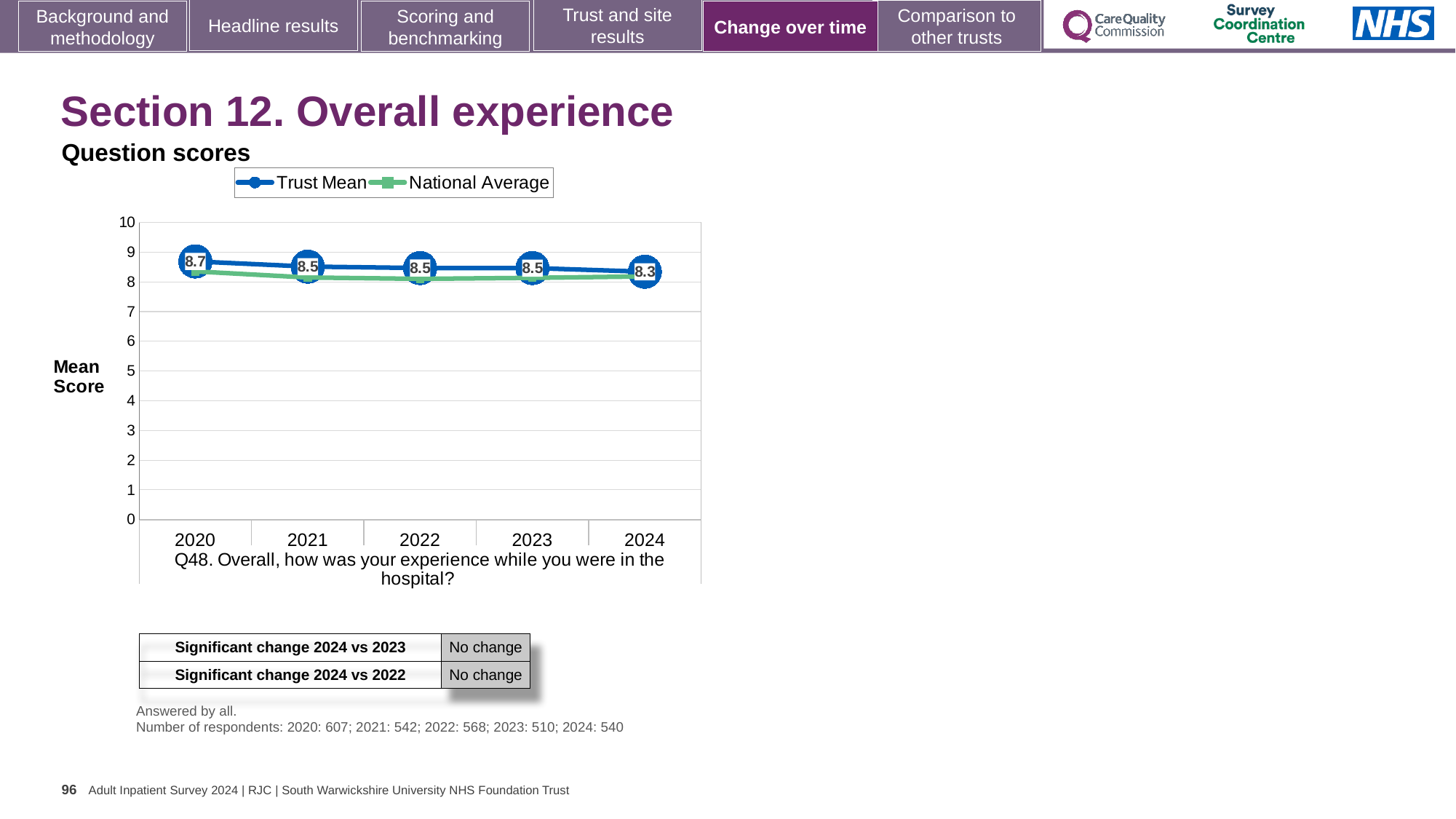
What is the difference between the Trust Mean score in 2020 and in 2024? 0.4 In which year is the Trust Mean score highest? 2020 What is the Trust Mean score for 2024? 8.3 How many years are plotted on the x axis? 5 What kind of chart is shown? Line chart Does the Trust Mean score rise or fall from 2020 to 2024? Fall In which year is the Trust Mean score lowest? 2024 Is the National Average value for 2024 greater or less than 9? less What is the Trust Mean score for 2020? 8.7 What is the Trust Mean score for 2022? 8.5 How many series does the legend list? 2 Which is larger, the Trust Mean score in 2020 or in 2024? 2020